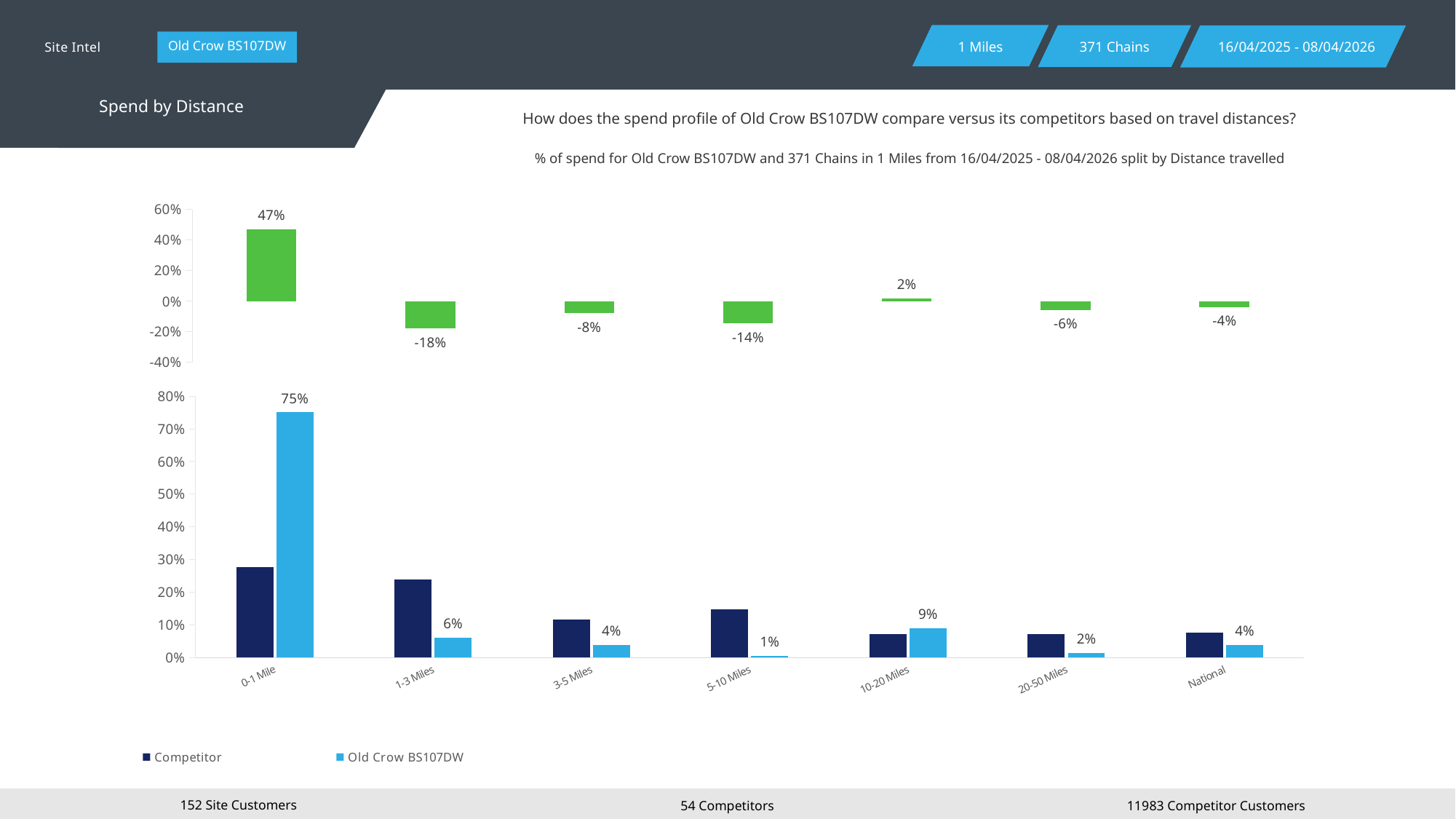
In the bottom bar chart, what is the value for Old Crow BS107DW in the 5-10 Miles category? 1% In the bottom bar chart, what is the value for Old Crow BS107DW in the 10-20 Miles category? 9% In the bottom bar chart, what is the difference between the Old Crow BS107DW values for 0-1 Mile and 1-3 Miles? 69% In the bottom bar chart, which is larger in the 1-3 Miles category, Competitor or Old Crow BS107DW? Competitor In the bottom bar chart, which category has the highest value for Old Crow BS107DW? 0-1 Mile In the bottom bar chart, which category has the lowest value for Old Crow BS107DW? 5-10 Miles How many series does the legend of the bottom bar chart list? 2 In the bottom bar chart, what is the value for Old Crow BS107DW in the 0-1 Mile category? 75% In the top chart, what is the value of the second bar from the left? -18% In the top chart, what is the value of the leftmost bar? 47% In the bottom bar chart, is the Competitor value for 3-5 Miles greater or less than 20%? less In the bottom bar chart, is the Competitor value for 0-1 Mile greater or less than 20%? greater